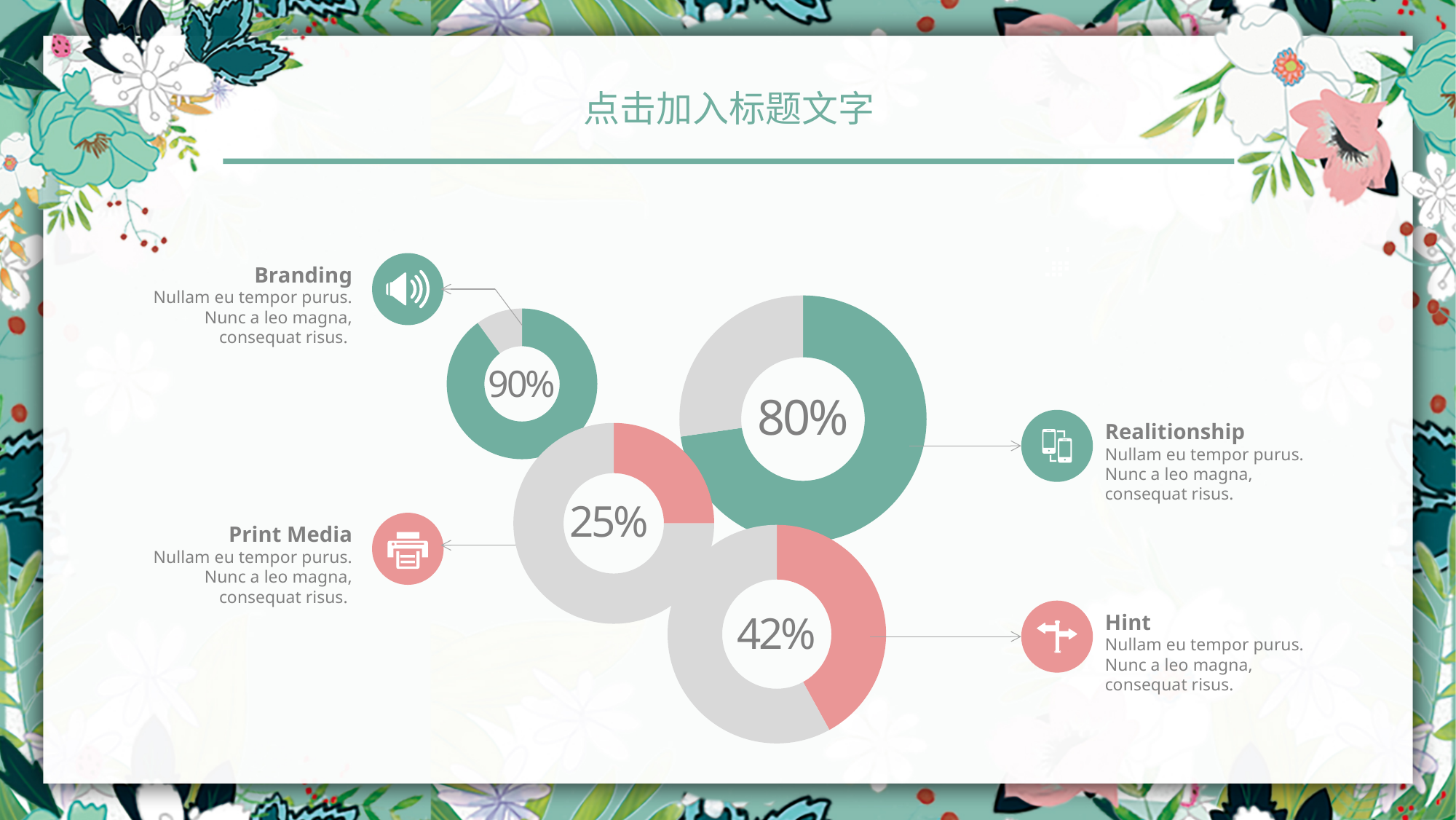
Which is larger, the Hint percentage or the Print Media percentage? Hint What is the difference between the Realitionship percentage and the Hint percentage? 38% What kind of chart is used to show the Branding value? Donut chart How many donut charts are shown on the slide? 4 Which of the four donut charts shows the lowest percentage? Print Media What percentage is shown in the Branding donut chart? 90% What percentage is shown in the Hint donut chart? 42% What percentage is shown in the Realitionship donut chart? 80% What colour is the filled portion of the Hint donut chart? Pink Which of the four donut charts shows the highest percentage? Branding What is the difference between the Branding percentage and the Print Media percentage? 65% What percentage is shown in the Print Media donut chart? 25%